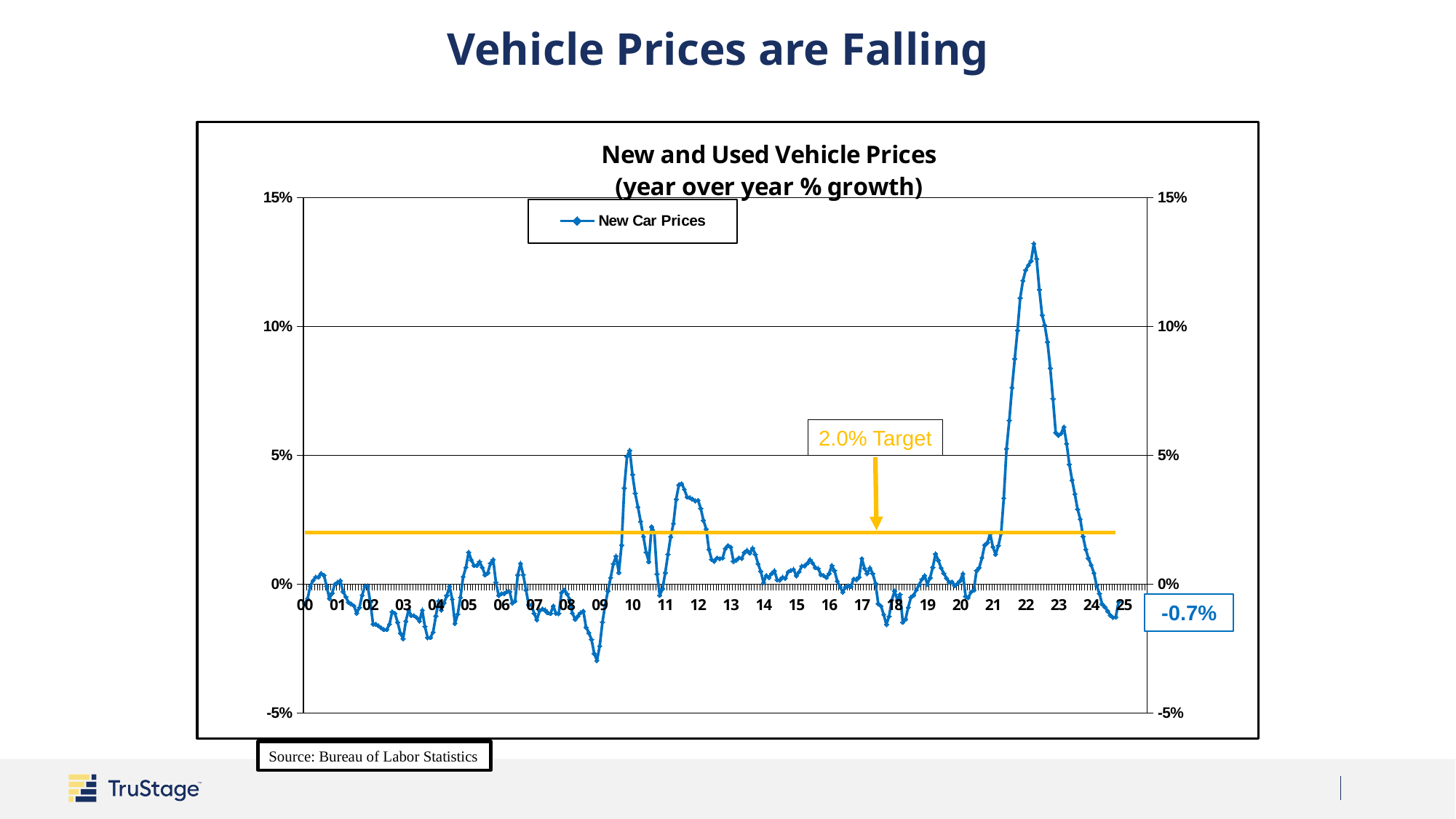
Is the New Car Prices growth value at the end of the series (2025) greater or less than the 2.0% target? less Is the peak value of New Car Prices growth around 2022 greater or less than 10%? greater What kind of chart is shown on the slide? line chart Does New Car Prices growth rise or fall between 2022 and 2025? fall What target level is marked by the horizontal line on the chart? 2.0% Target What series name appears in the chart legend? New Car Prices What is the most recent value of New Car Prices growth labeled on the chart? -0.7% What is the title of the chart? New and Used Vehicle Prices (year over year % growth) How many series does the chart legend list? 1 Is the lowest value of New Car Prices growth around 2009 greater or less than 0%? less In which year on the x axis does New Car Prices growth reach its highest peak? 22 How many year labels are shown on the x axis? 26